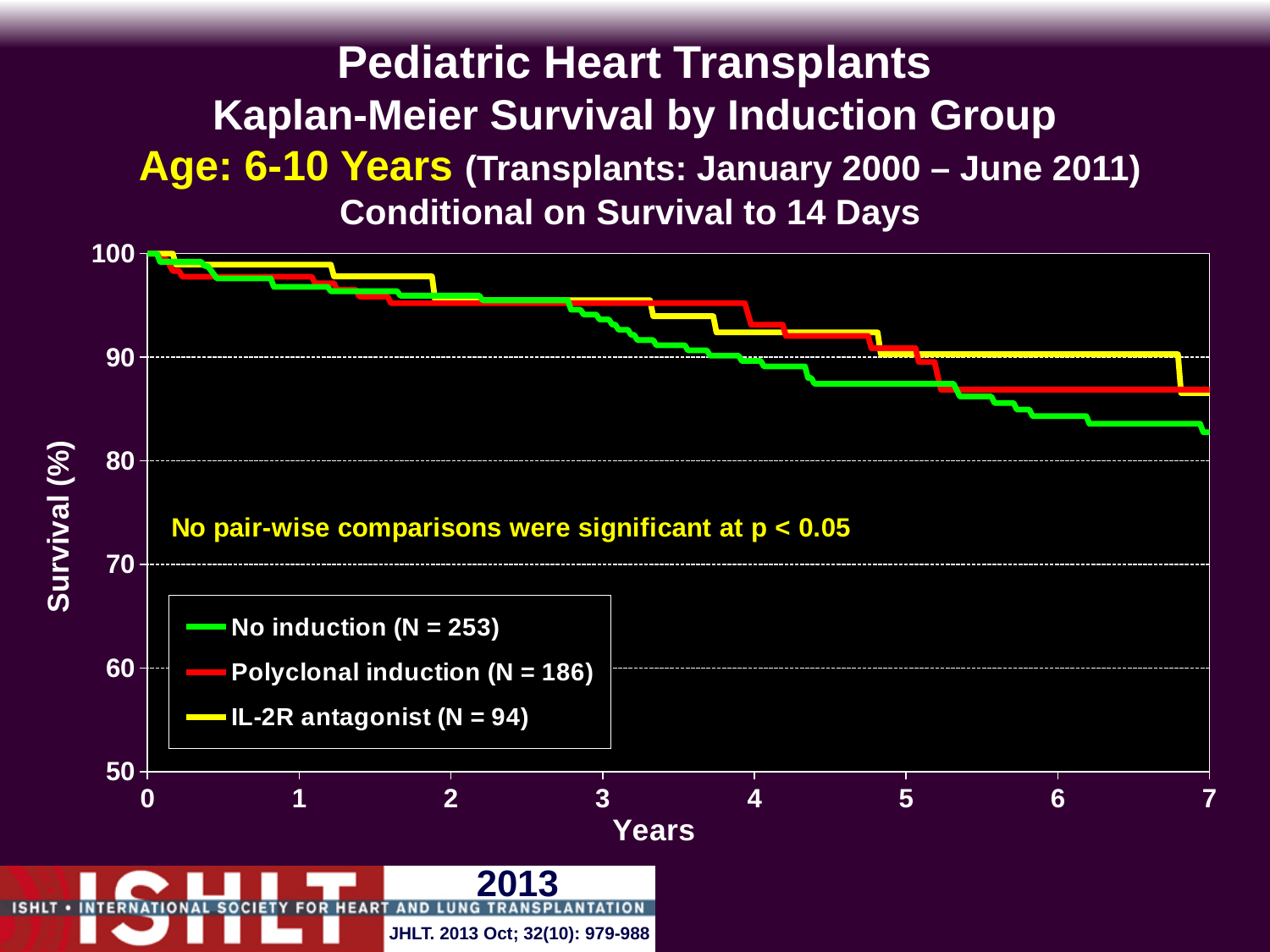
Is the survival for IL-2R antagonist at 2 years greater or less than 90? greater Is the survival for No induction at 7 years greater or less than 80? greater Is the survival for Polyclonal induction at 7 years greater or less than 90? less How many tick marks are labelled on the Years axis? 8 What kind of chart is shown on the slide? Line chart What is the N for the No induction group shown in the legend? N = 253 Do the survival curves rise or fall as years increase? fall At 7 years, which is larger: survival for No induction or for Polyclonal induction? Polyclonal induction Which colour represents the IL-2R antagonist group? Yellow Which induction group has the lowest survival at 7 years? No induction How many series does the legend list? 3